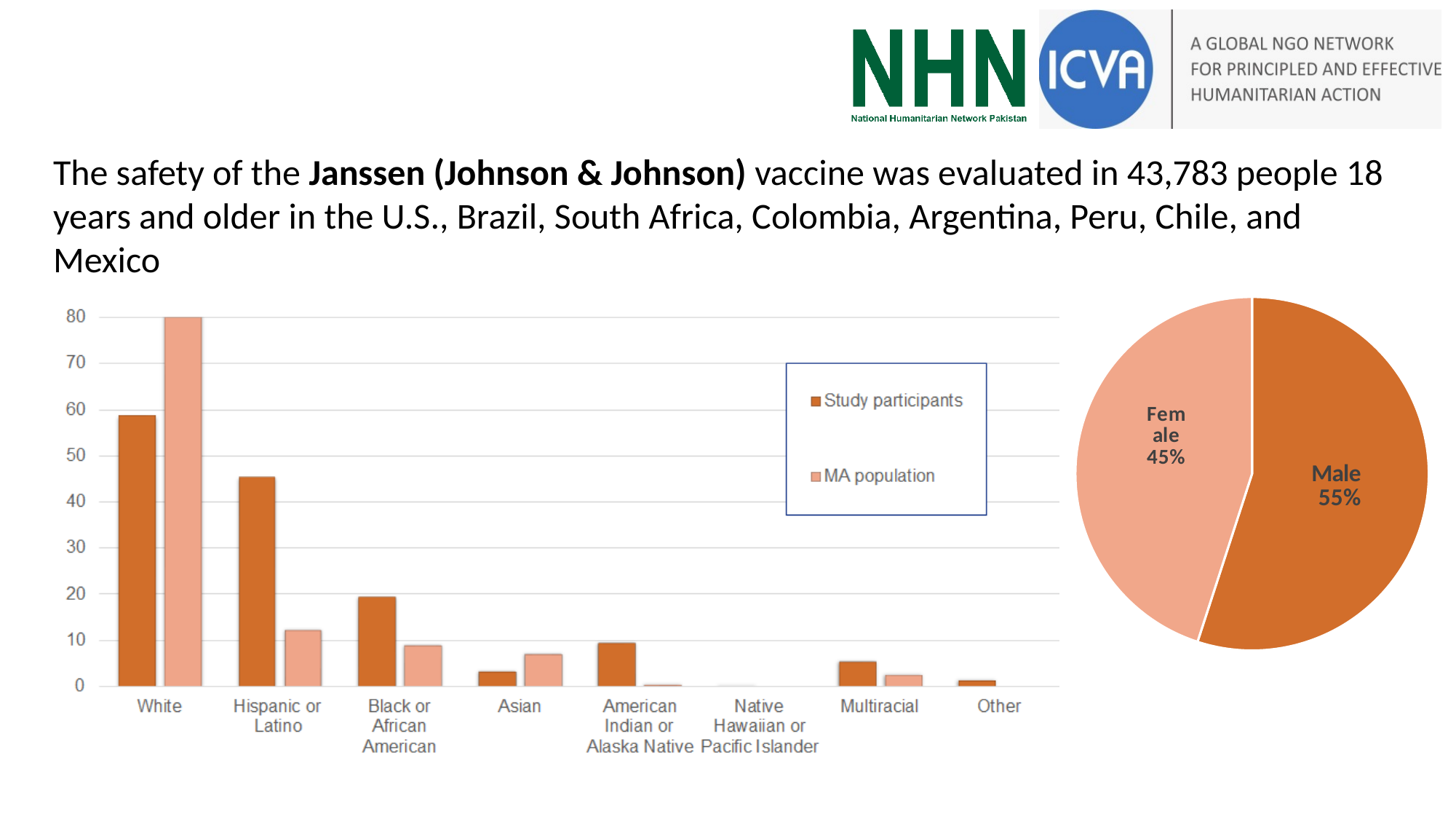
On the right pie chart, what is the difference between the Male and Female shares? 10% On the left bar chart, is the Study participants value for White greater or less than 50? greater On the left bar chart, what kind of chart is it? bar chart On the right pie chart, what share is Male? 55% On the left bar chart, which category has the highest Study participants value? White On the left bar chart, how many series does the legend list? 2 On the right pie chart, what share is Female? 45% On the left bar chart, how many categories are shown on the x axis? 8 On the left bar chart, for the White category, which is larger: Study participants or MA population? MA population On the left bar chart, which category has the highest MA population value? White On the left bar chart, for the Hispanic or Latino category, which is larger: Study participants or MA population? Study participants On the left bar chart, is the MA population value for Asian greater or less than 10? less